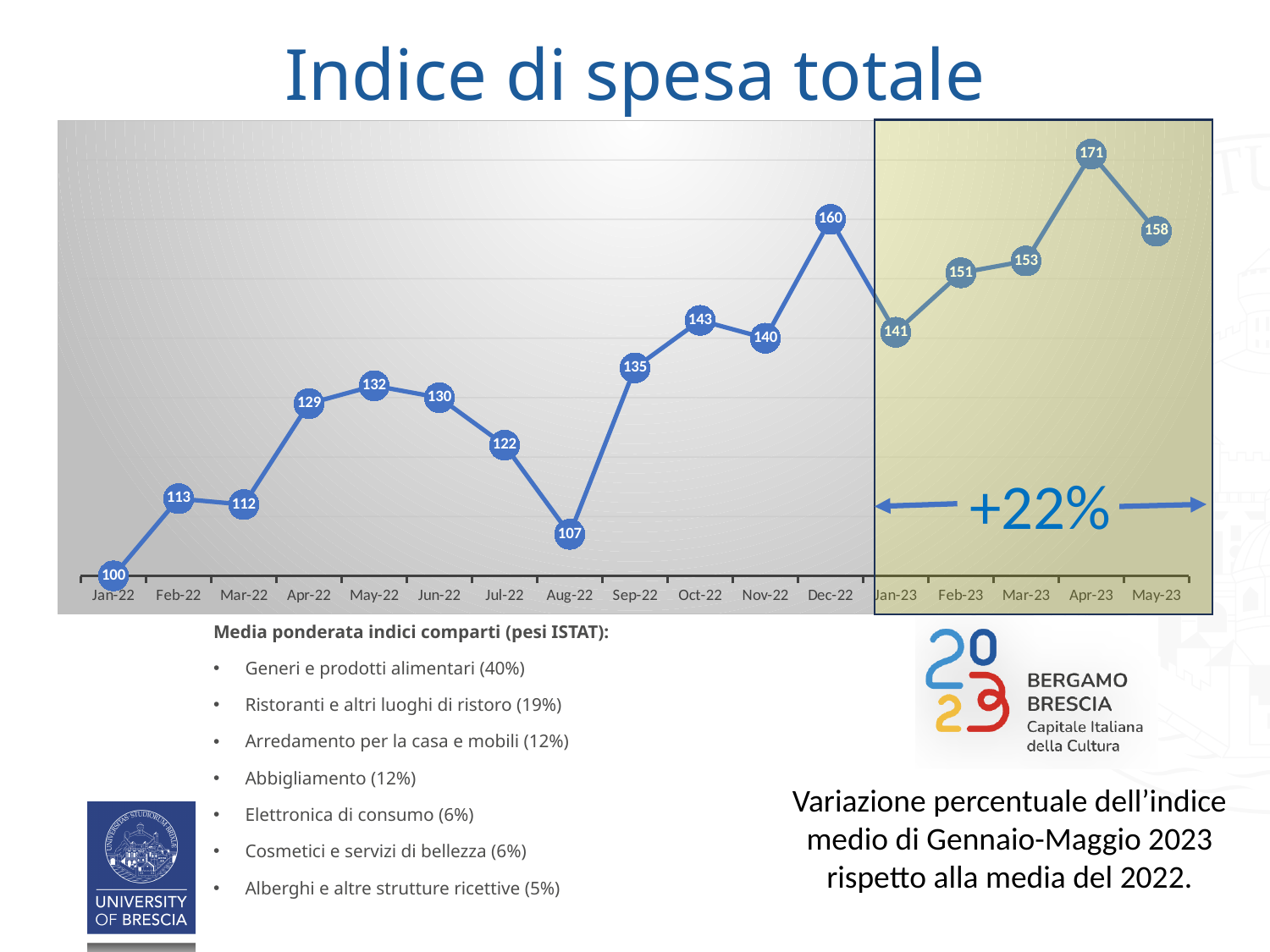
What is the value of the index for Apr-23? 171 What is the value of the index for Dec-22? 160 What is the value of the index for Aug-22? 107 Which month has the lowest index value? Jan-22 What is the title of the chart on the slide? Indice di spesa totale Does the index value rise or fall from Jan-22 to Apr-22? Rise What kind of chart is shown on the slide? Line chart Which is larger, the index value for Oct-22 or for Nov-22? Oct-22 What is the difference between the index values for Apr-23 and May-23? 13 How many data points are plotted on the chart? 17 Which month has the highest index value? Apr-23 What is the difference between the index values for Dec-22 and Jan-23? 19